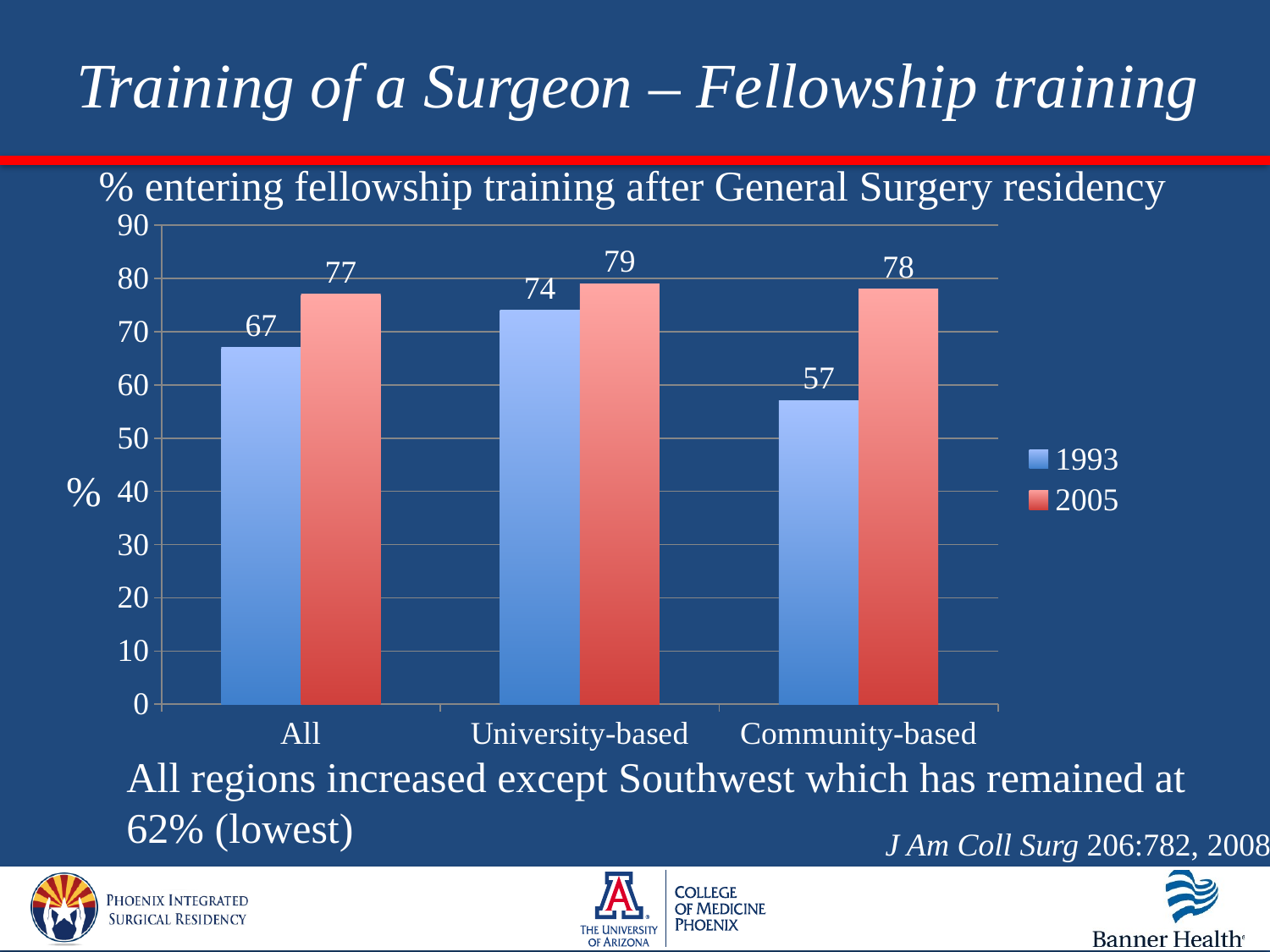
How many categories are shown on the x axis? 3 What is the difference between the 2005 and 1993 values for Community-based? 21 What is the title of the chart? % entering fellowship training after General Surgery residency How many series does the legend list? 2 What is the 2005 value for University-based? 79 Which is larger, the 1993 value for University-based or the 1993 value for All? University-based What is the difference between the 2005 and 1993 values for All? 10 What is the 1993 value for All? 67 What kind of chart is shown on the slide? Bar chart Which category has the highest 2005 value? University-based Which category has the lowest 1993 value? Community-based What is the 1993 value for Community-based? 57